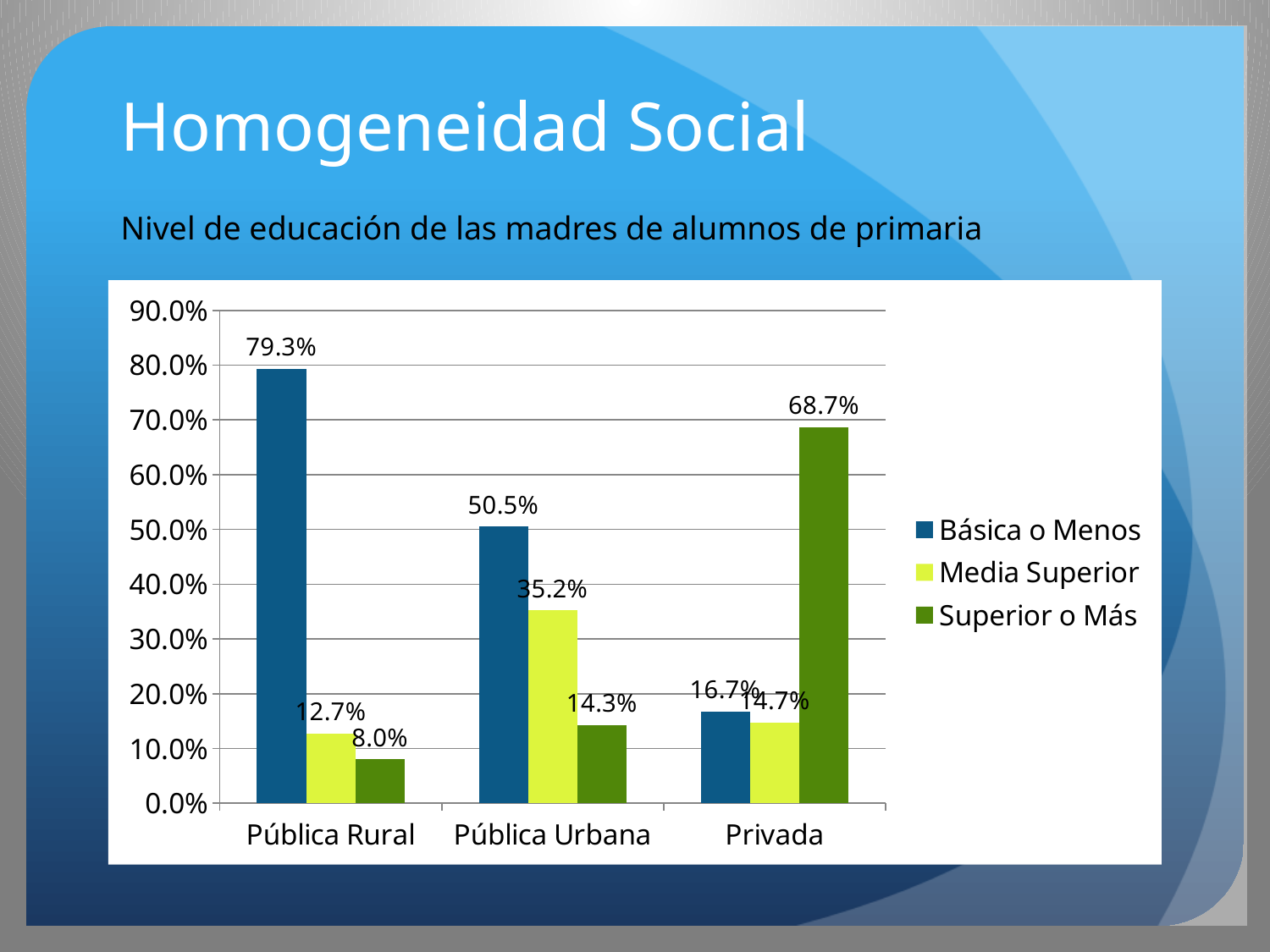
What is the value for Superior o Más in Pública Rural? 8.0% Is the value for Media Superior in Pública Urbana greater or less than 30.0%? greater What is the value for Básica o Menos in Pública Rural? 79.3% How many categories are shown on the x axis? 3 What is the value for Superior o Más in Privada? 68.7% Which is larger in Privada: Básica o Menos or Superior o Más? Superior o Más What is the difference between Básica o Menos in Pública Rural and Básica o Menos in Pública Urbana? 28.8% What kind of chart is shown on the slide? bar chart How many series does the legend list? 3 Which category has the highest value for Básica o Menos? Pública Rural Which category has the lowest value for Superior o Más? Pública Rural What is the value for Media Superior in Pública Urbana? 35.2%